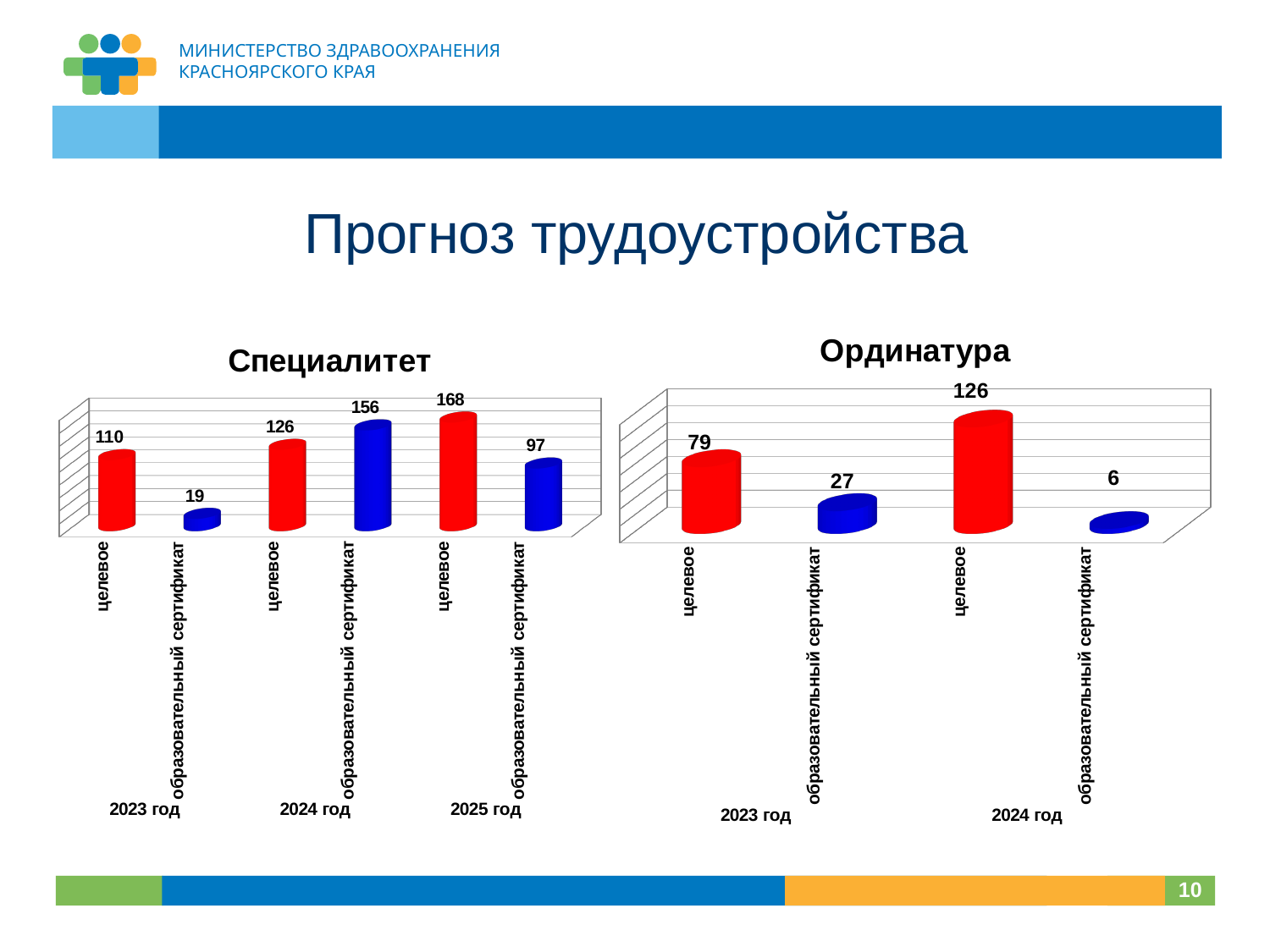
In the "Специалитет" chart, which is larger in 2024 год: целевое or образовательный сертификат? образовательный сертификат In the "Специалитет" chart, what is the value for образовательный сертификат in 2024 год? 156 In the "Ординатура" chart, what is the value for образовательный сертификат in 2023 год? 27 In the "Специалитет" chart, what is the value for целевое in 2023 год? 110 In the "Специалитет" chart, which bar has the highest value? целевое, 2025 год In the "Ординатура" chart, what is the value for целевое in 2024 год? 126 How many bars are plotted in the "Ординатура" chart? 4 What kind of chart is the "Специалитет" chart? bar chart In the "Специалитет" chart, what is the difference between целевое in 2025 год and целевое in 2024 год? 42 In the "Ординатура" chart, which bar has the lowest value? образовательный сертификат, 2024 год In the "Ординатура" chart, what is the difference between целевое and образовательный сертификат in 2023 год? 52 In the "Специалитет" chart, do the целевое values rise or fall from 2023 год to 2025 год? rise